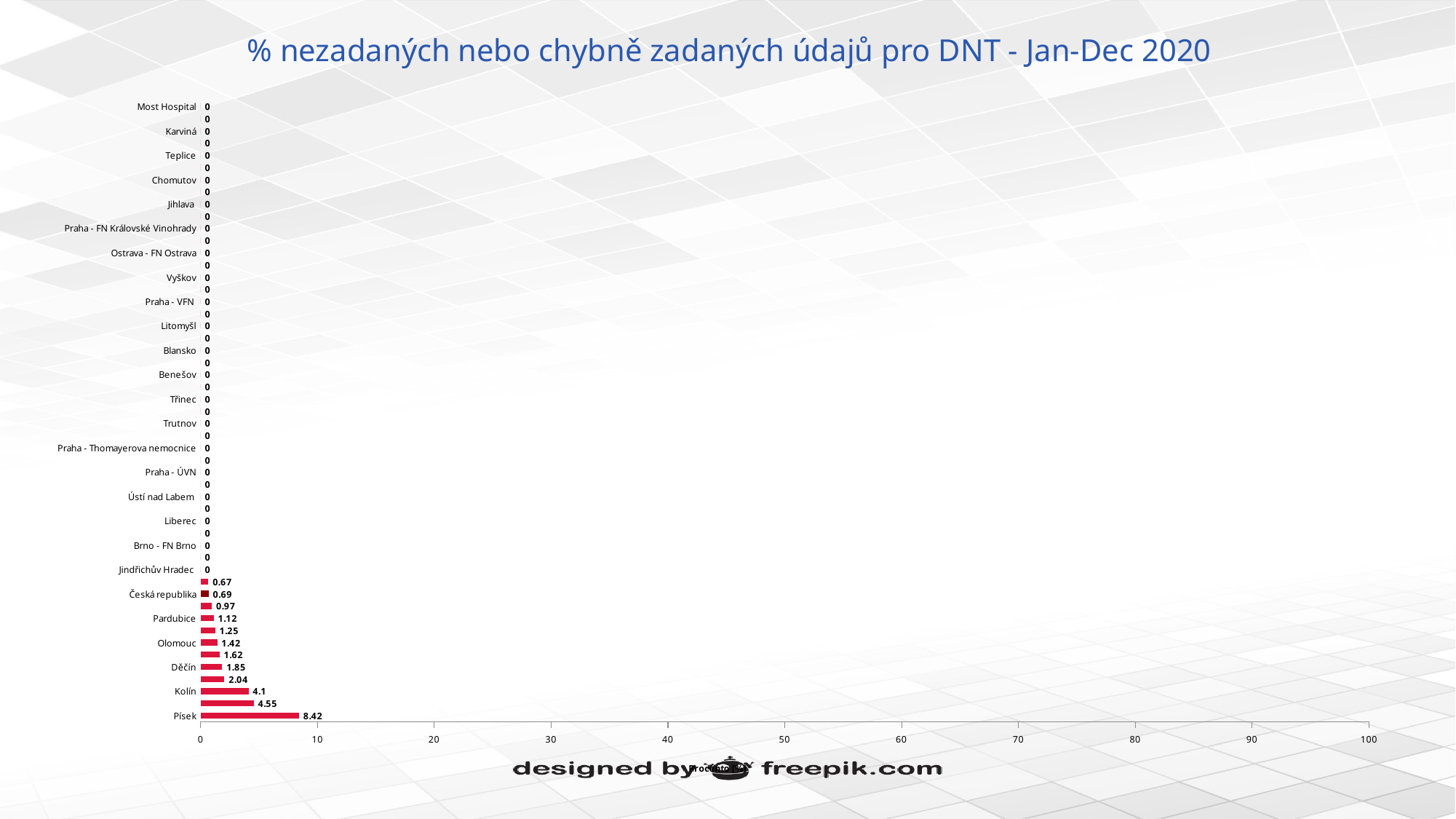
What kind of chart is shown on the slide? Bar chart Which has a larger value, Olomouc or Pardubice? Olomouc What is the value for Olomouc? 1.42 What is the difference between the values for Písek and Kolín? 4.32 What is the value for Děčín? 1.85 Is the value for Písek greater or less than 10? less What is the value for Písek? 8.42 Which category has the highest value? Písek What is the value for Kolín? 4.1 What is the value for Česká republika? 0.69 What is the title of the chart? % nezadaných nebo chybně zadaných údajů pro DNT - Jan-Dec 2020 What is the value for Jindřichův Hradec? 0